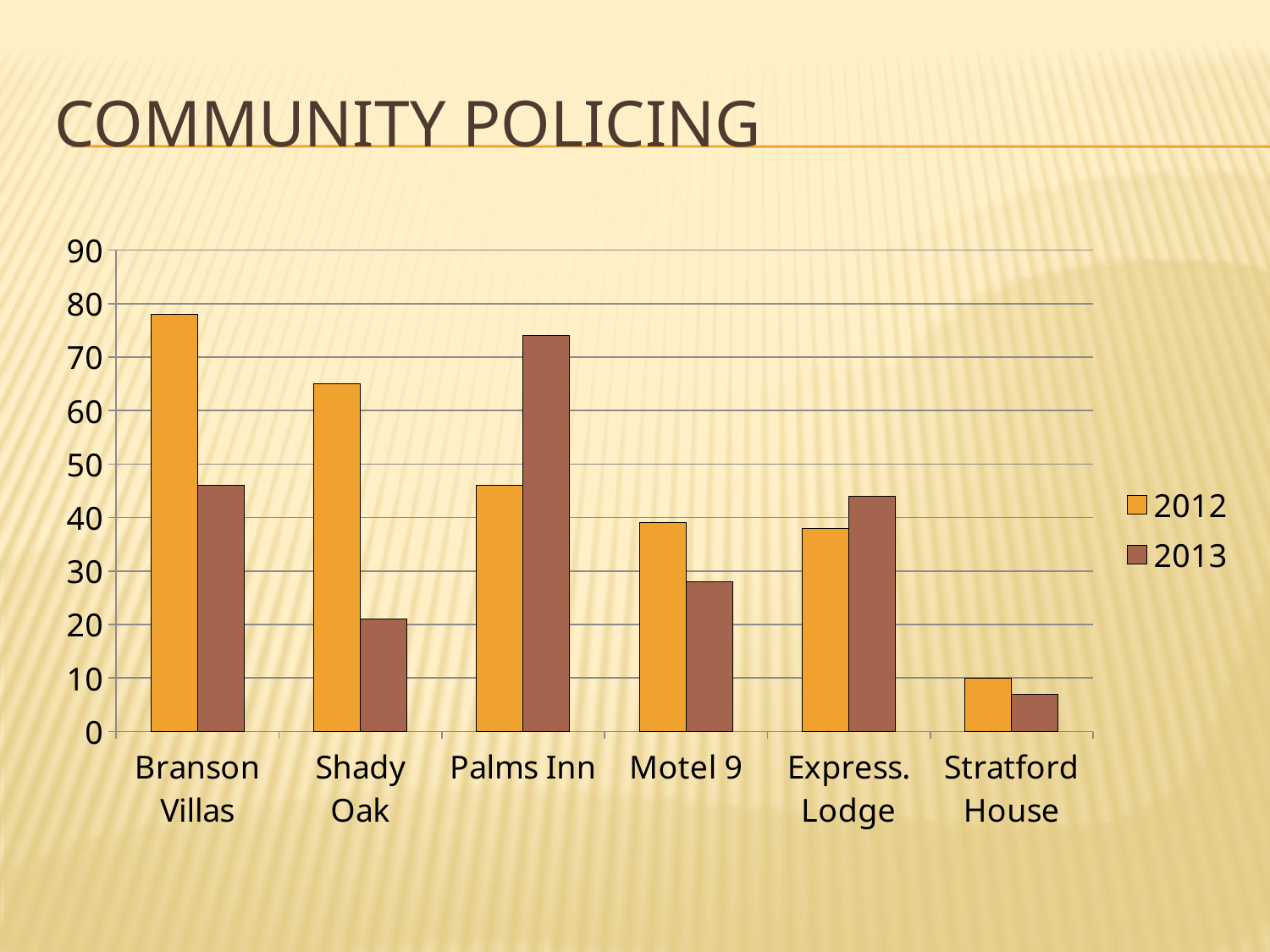
Is the 2012 value for Branson Villas greater or less than 70? greater Is the 2013 value for Palms Inn greater or less than 70? greater Which category has the lowest 2013 value? Stratford House What kind of chart is shown on the slide? bar chart How many series does the legend list? 2 For Palms Inn, which is larger, the 2012 value or the 2013 value? 2013 How many categories are shown on the x axis? 6 Which category has the highest 2013 value? Palms Inn For Motel 9, which is larger, the 2012 value or the 2013 value? 2012 Which category has the highest 2012 value? Branson Villas Is the 2013 value for Shady Oak greater or less than 30? less What is the title of the slide containing the chart? COMMUNITY POLICING